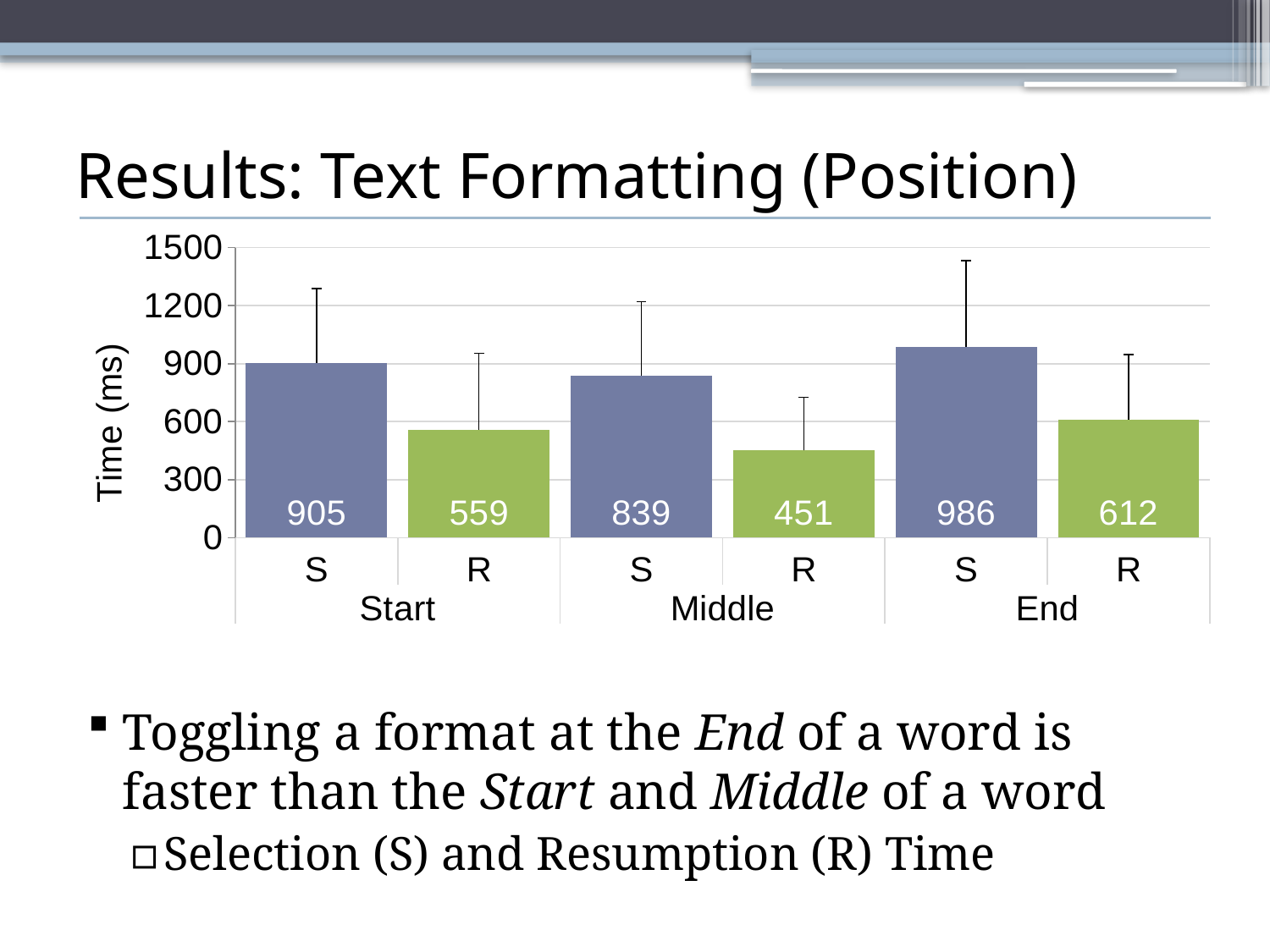
Which bar has the lowest value in the chart? Middle R (451) How many bars are plotted in the chart? 6 What is the Resumption (R) time for the Middle position? 451 What kind of chart is shown on the slide? bar chart What is the difference between the S and R times for the Start position? 346 What is the Selection (S) time for the Start position? 905 Which bar has the highest value in the chart? End S (986) Is the S time for Middle greater or less than 900? less What is the Selection (S) time for the End position? 986 What is the label of the vertical axis? Time (ms) Which is larger, the R time for End or the R time for Start? End R (612) What is the difference between the S times for End and Middle? 147